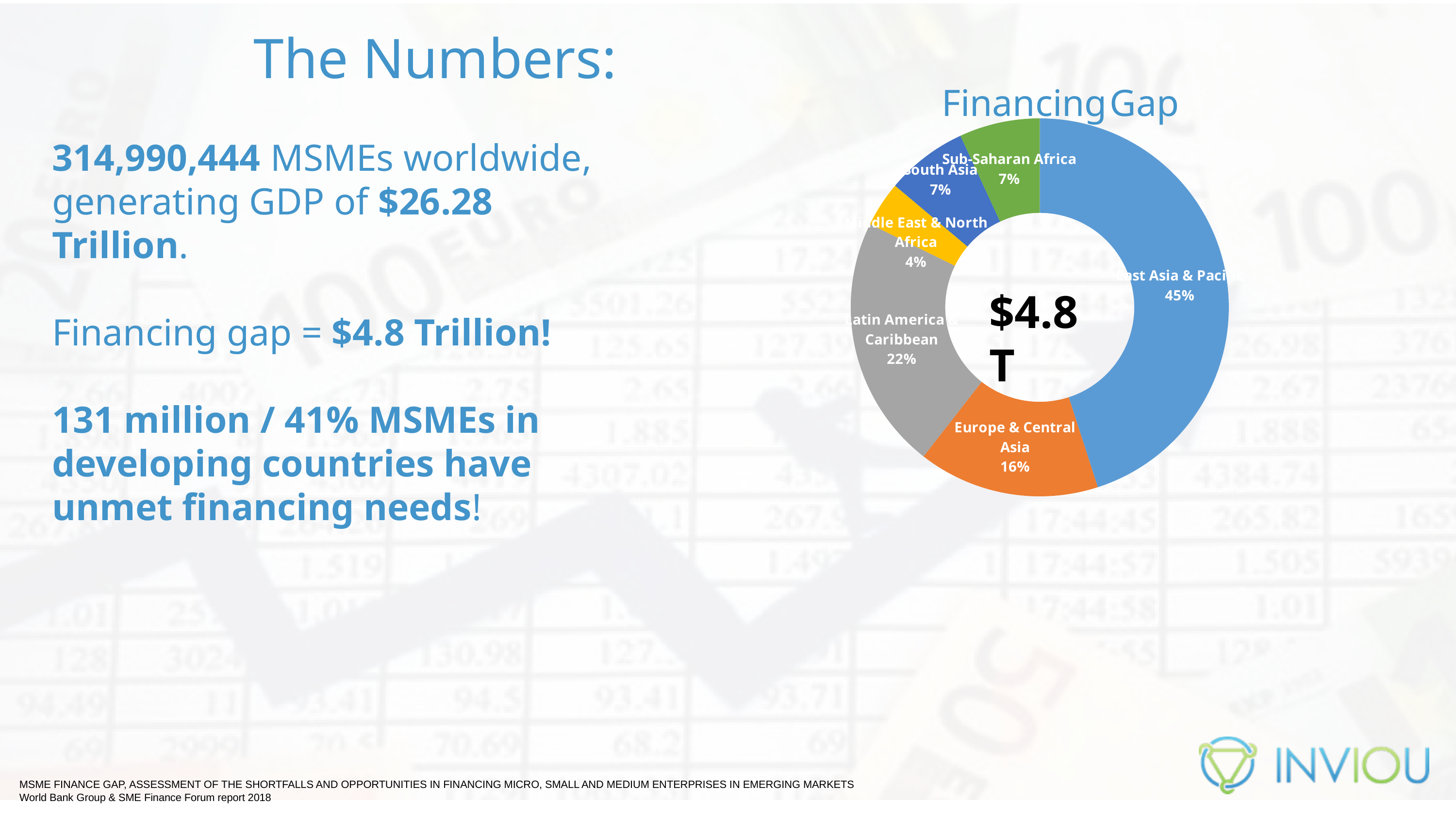
What value is printed in the centre of the Financing Gap chart? $4.8 T What is the difference in percentage points between East Asia & Pacific and Latin America & Caribbean? 23 percentage points Which region has the largest share of the financing gap? East Asia & Pacific Which region has the smallest share of the financing gap? Middle East & North Africa What is the title of the chart on the slide? Financing Gap What share of the financing gap does East Asia & Pacific account for? 45% How many regions are shown in the Financing Gap chart? 6 Which has a larger share: Latin America & Caribbean or Europe & Central Asia? Latin America & Caribbean What percentage is shown for Middle East & North Africa? 4% What kind of chart is the Financing Gap chart? doughnut chart What percentage is shown for Latin America & Caribbean? 22% What percentage is shown for Europe & Central Asia? 16%